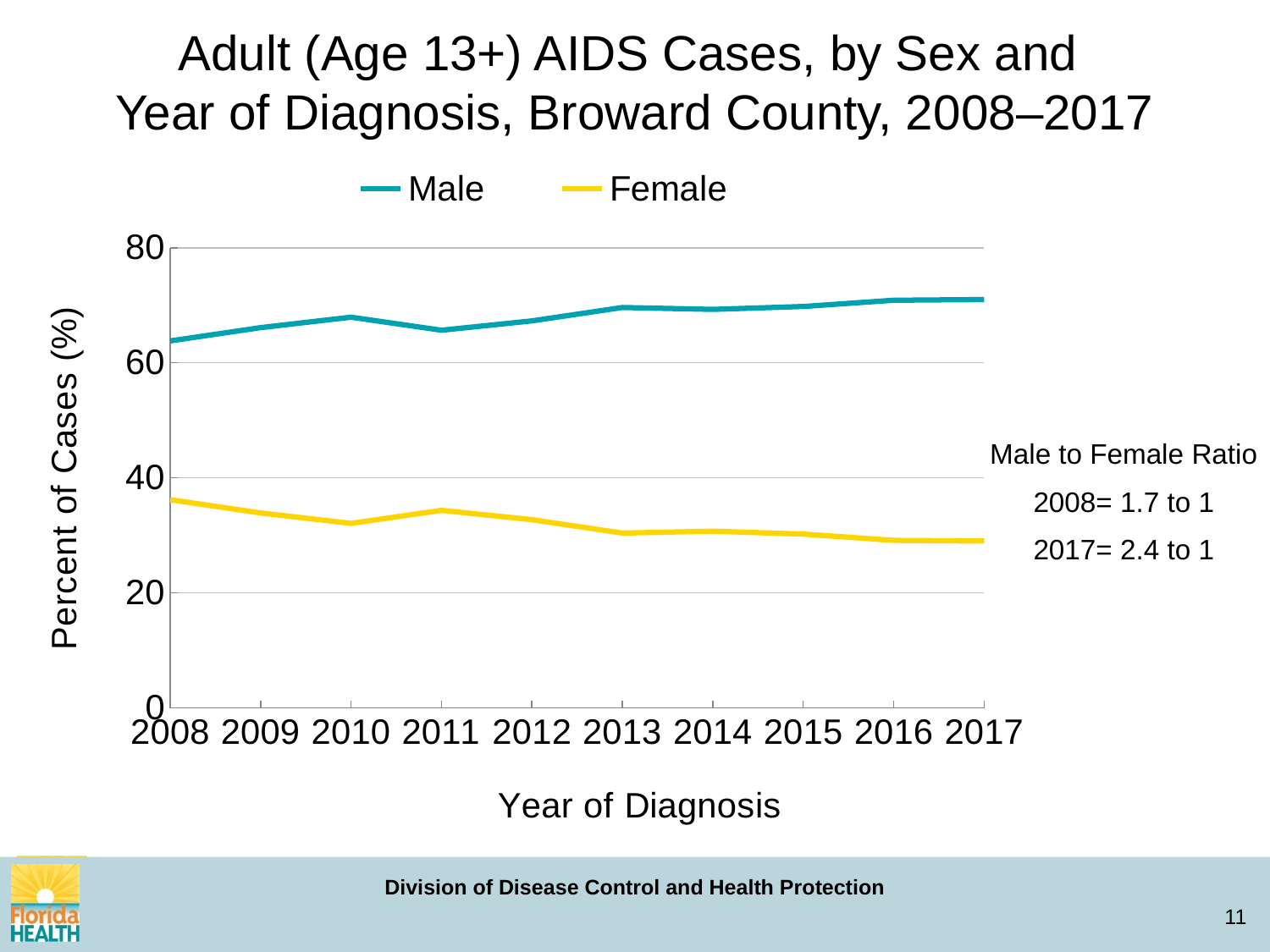
Is the Female value for 2017 greater or less than 20? greater Does the Male line generally rise or fall from 2008 to 2017? Rise Does the Female line generally rise or fall from 2008 to 2017? Fall Is the Female value for 2008 greater or less than 40? less How many series does the legend list? 2 Is the Male value for 2008 greater or less than 60? greater What kind of chart is shown on the slide? Line chart How many years are plotted along the x axis? 10 In which year is the Female percentage highest? 2008 In 2012, which series has the larger value, Male or Female? Male What is the label on the y axis of the chart? Percent of Cases (%)